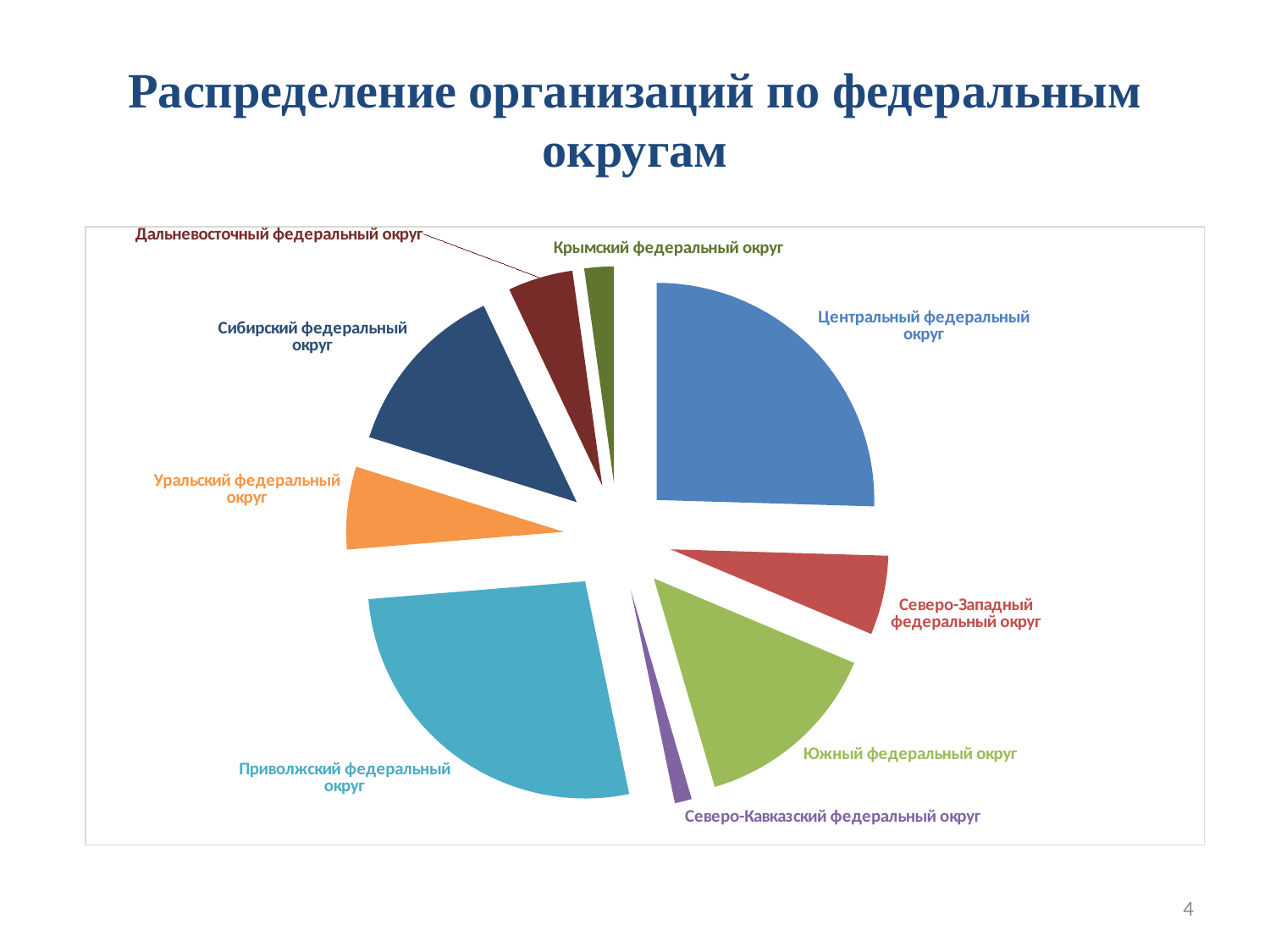
What kind of chart is shown on the slide? pie chart Which federal district has the smallest slice in the pie chart? Северо-Кавказский федеральный округ Which slice is larger: Сибирский федеральный округ or Уральский федеральный округ? Сибирский федеральный округ Which slice is larger: Центральный федеральный округ or Сибирский федеральный округ? Центральный федеральный округ Which slice is larger: Крымский федеральный округ or Северо-Кавказский федеральный округ? Крымский федеральный округ What is the title of the slide's chart? Распределение организаций по федеральным округам What colour is the slice for Уральский федеральный округ? orange How many federal districts (slices) does the pie chart show? 9